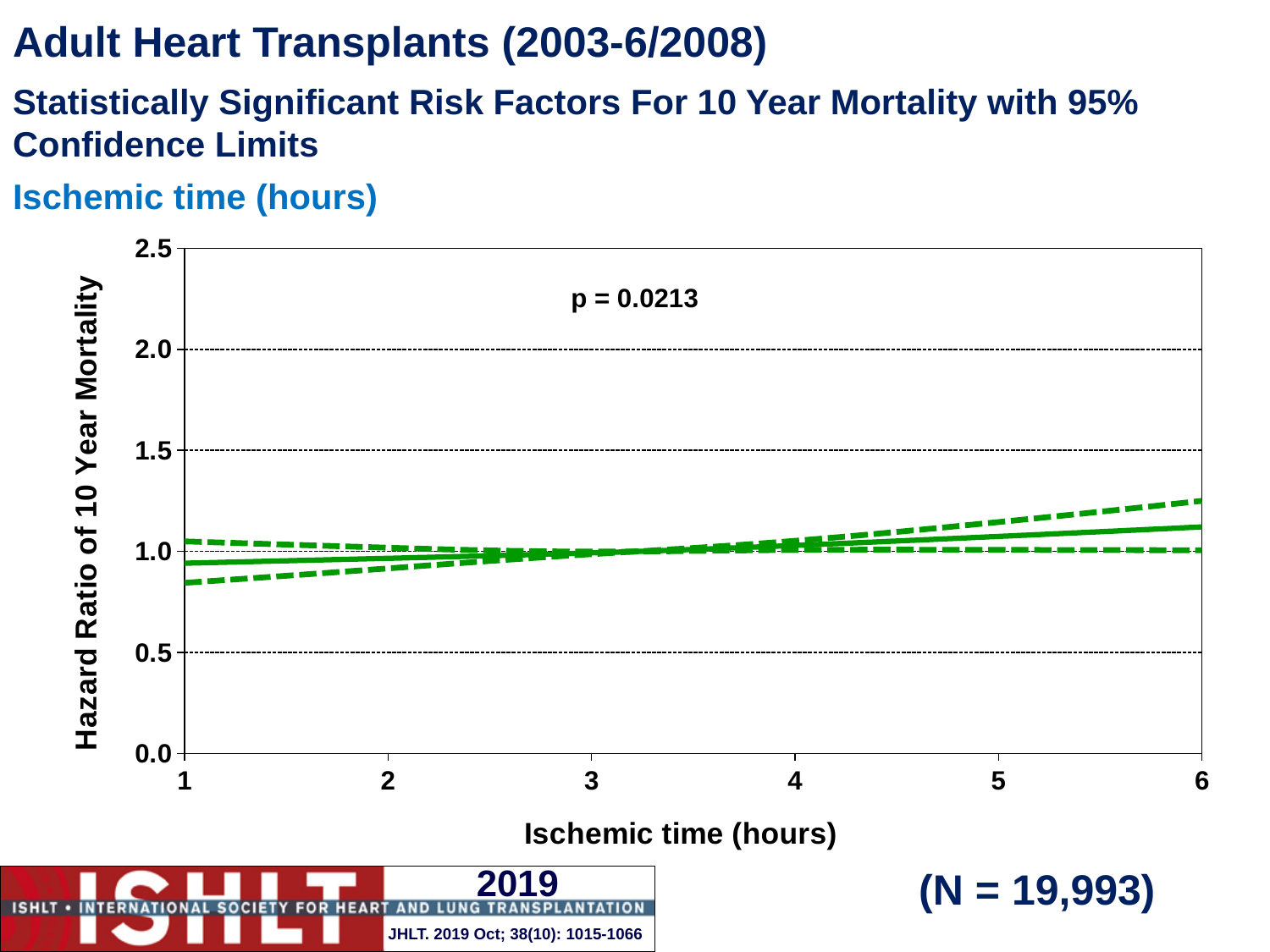
Is the lower 95% confidence limit (lower dashed line) at 1 hour greater or less than 1.0? less Is the hazard ratio (solid line) at 6 hours greater or less than 1.5? less Does the solid hazard ratio line rise or fall as ischemic time increases from 1 to 6 hours? rise Is the hazard ratio (solid line) at an ischemic time of 6 hours greater or less than 1.0? greater How many tick labels are shown on the x axis? 6 What kind of chart is shown on the slide? line chart What p-value is printed on the chart? p = 0.0213 What is the label of the y axis? Hazard Ratio of 10 Year Mortality How many lines are plotted on the chart? 3